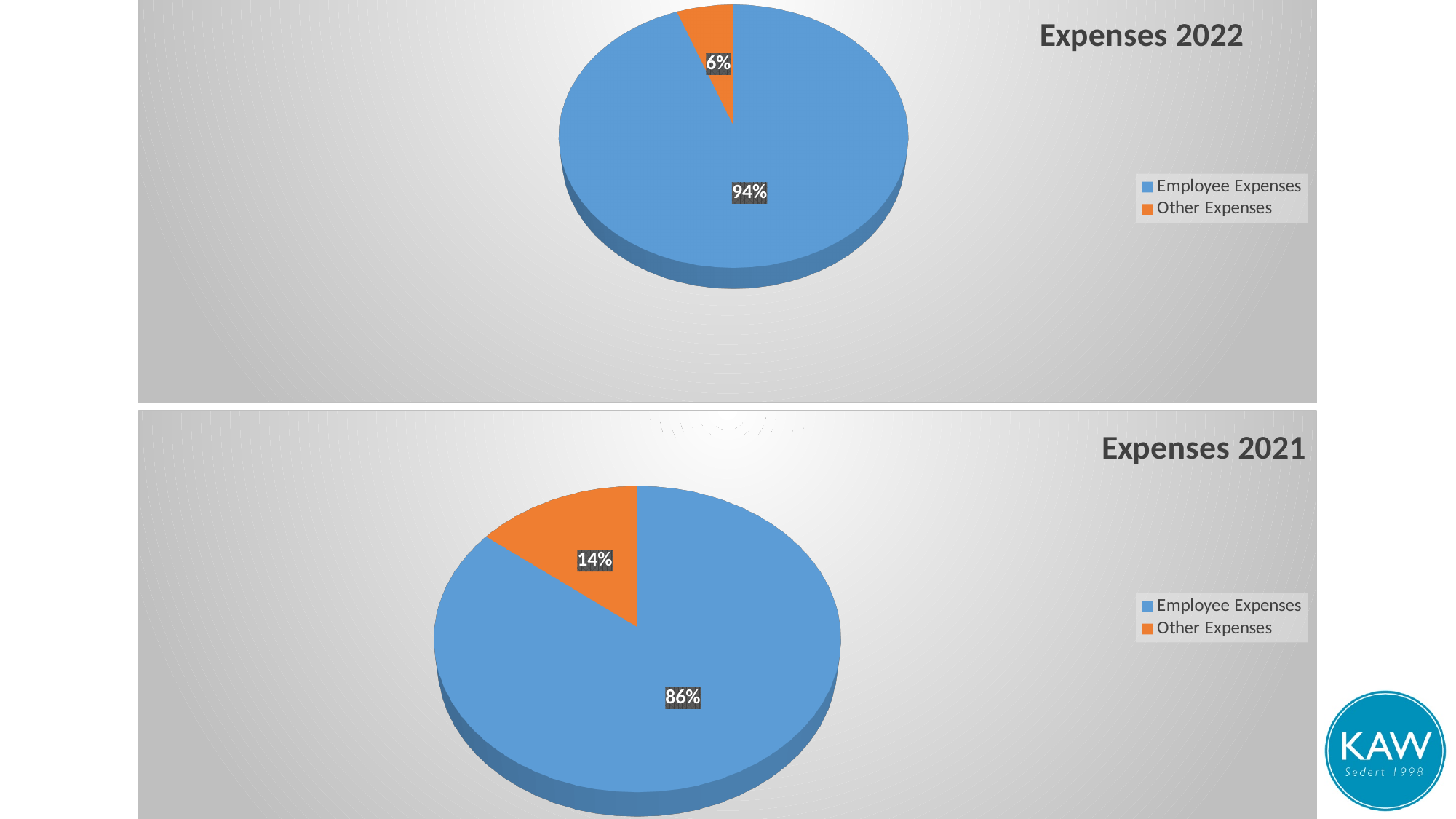
In the Expenses 2022 chart, what share of the pie is Other Expenses? 6% How many slices does the Expenses 2021 pie chart have? 2 In the Expenses 2021 chart, what share of the pie is Other Expenses? 14% In the Expenses 2021 chart, what share of the pie is Employee Expenses? 86% In the Expenses 2021 chart, what colour is the Other Expenses slice? Orange In the Expenses 2022 chart, which category has the largest slice? Employee Expenses How many entries does the legend of the Expenses 2022 chart list? 2 Is the Other Expenses share larger in the Expenses 2022 chart or the Expenses 2021 chart? Expenses 2021 In the Expenses 2021 chart, which category has the smallest slice? Other Expenses What kind of chart is the Expenses 2022 chart? Pie chart In the Expenses 2021 chart, what is the difference between the Employee Expenses share and the Other Expenses share? 72%